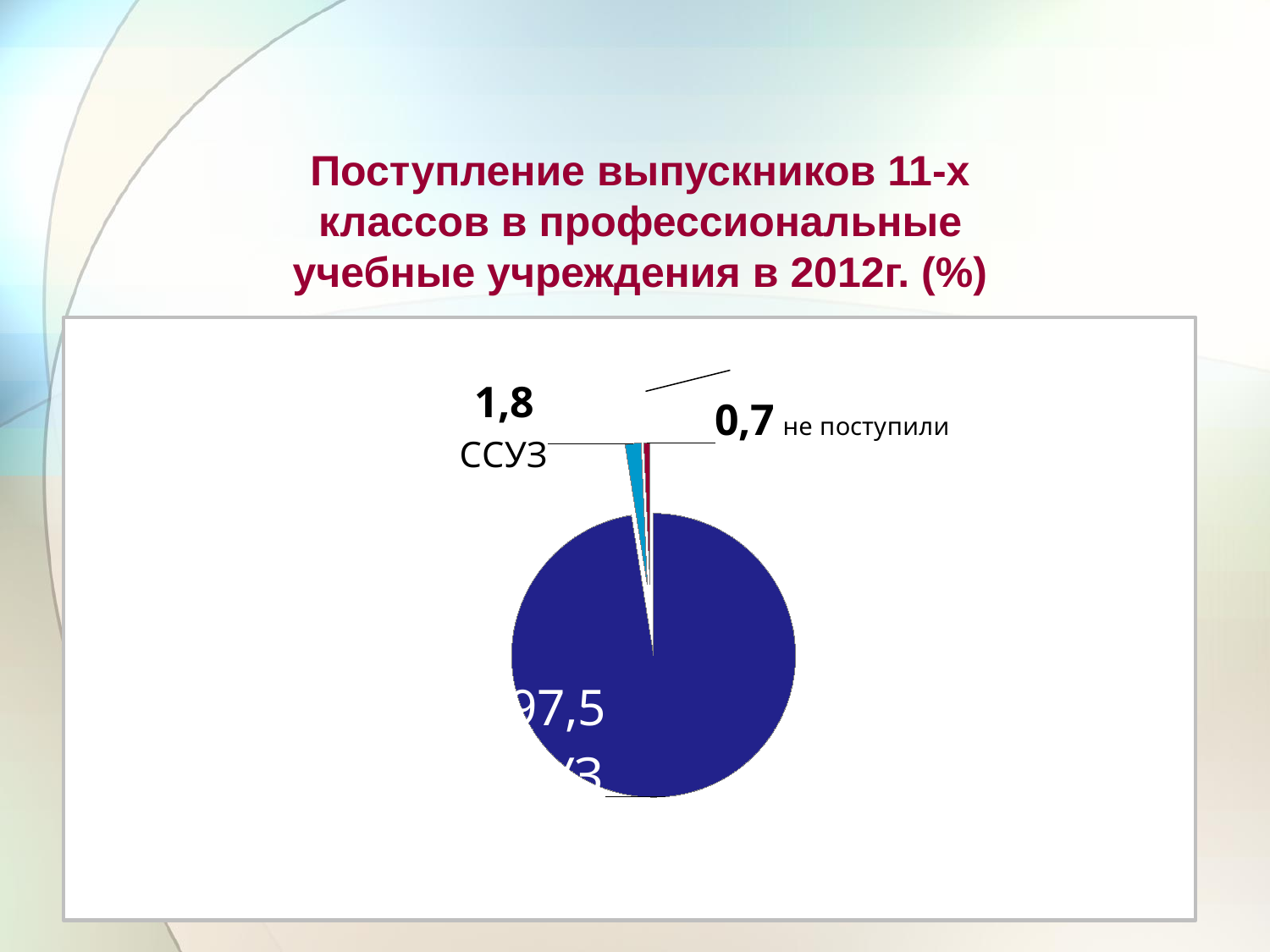
What is the difference between the value for ССУЗ and the value for не поступили? 1,1 What kind of chart is shown on the slide? pie chart What is the value for не поступили in the pie chart? 0,7 Is the value for ССУЗ greater or less than 1? greater How many slices does the pie chart have? 3 What colour is the largest slice of the pie chart? dark blue What year does the chart title refer to? 2012 What is the value for ССУЗ in the pie chart? 1,8 Is the value for не поступили greater or less than 1? less What is the value shown on the largest (dark blue) slice of the pie chart? 97,5 Which is larger, the value for ССУЗ or the value for не поступили? ССУЗ Which labelled slice is the smallest in the pie chart? не поступили